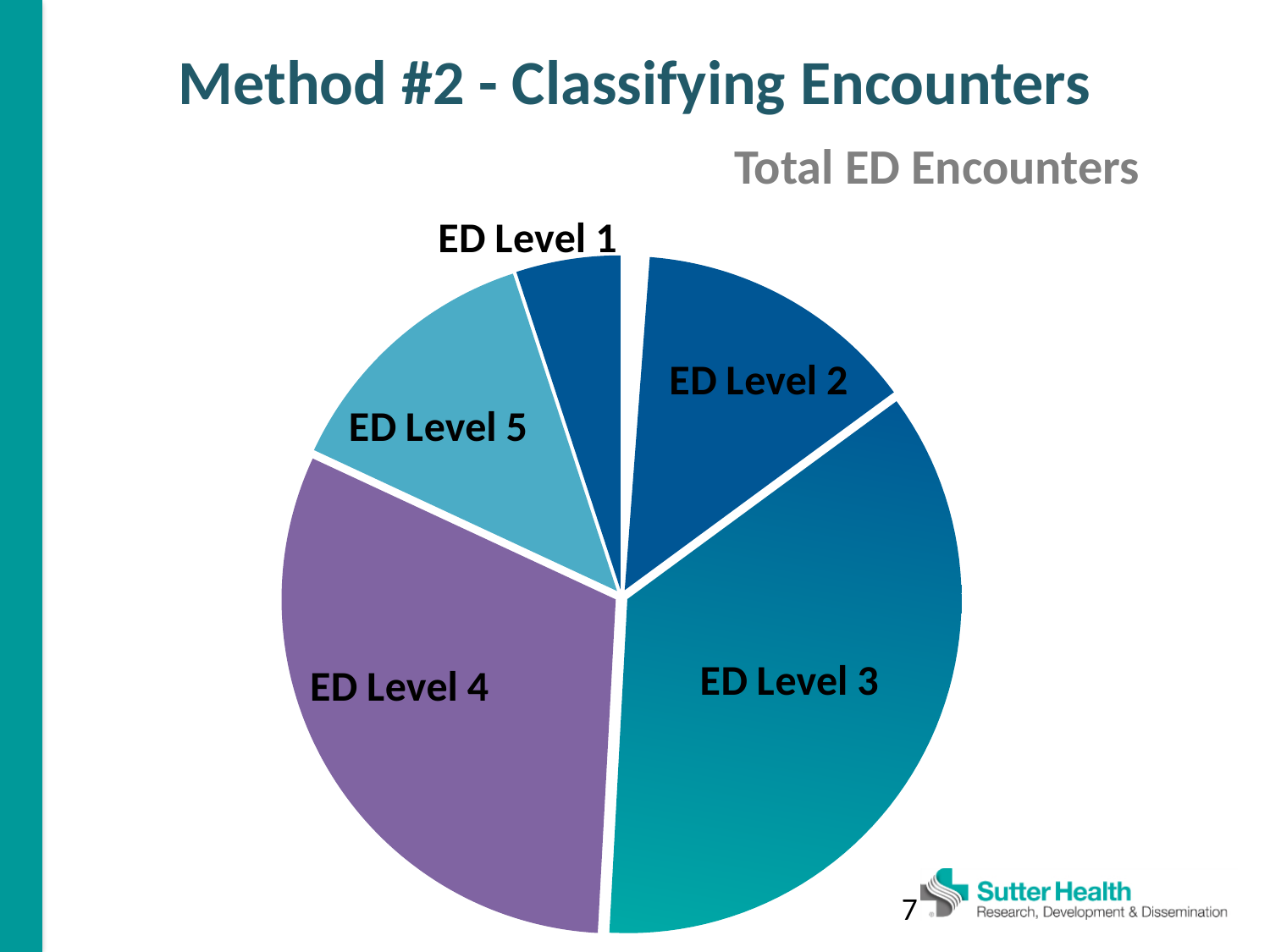
Which slice is larger, ED Level 3 or ED Level 2? ED Level 3 Which slice is larger, ED Level 4 or ED Level 5? ED Level 4 What colour is the ED Level 4 slice? purple What kind of chart is shown on the slide? pie chart Which slice is larger, ED Level 2 or ED Level 1? ED Level 2 Which ED level has the smallest share of total ED encounters? ED Level 1 How many slices does the pie chart have? 5 What is the title of the pie chart? Total ED Encounters Which ED level has the largest share of total ED encounters? ED Level 3